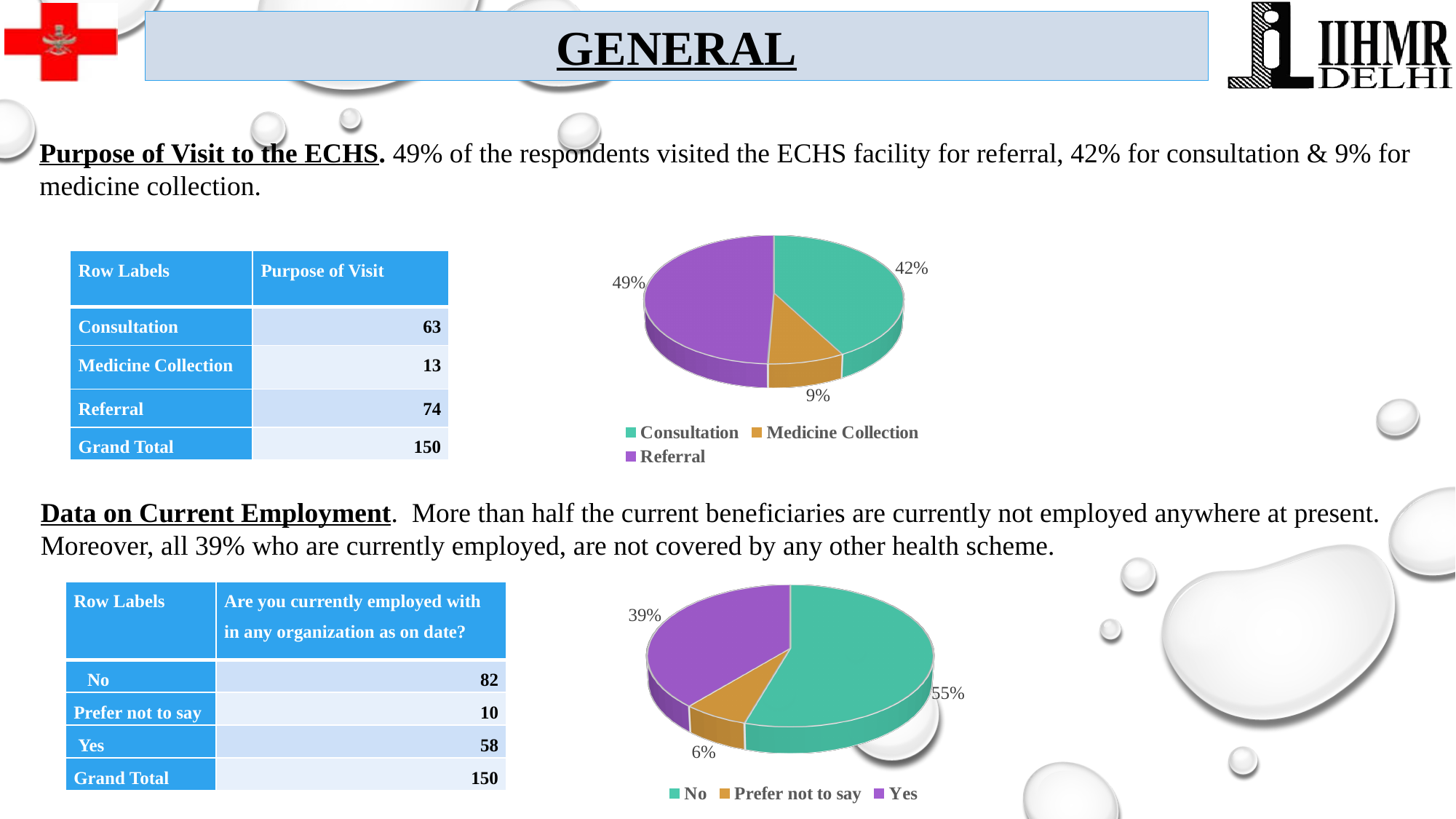
In the bottom pie chart (current employment), which category has the smallest slice? Prefer not to say What kind of chart is the bottom chart on the slide (current employment)? Pie chart In the top pie chart (Purpose of Visit), what is the difference between the Referral and Consultation percentages? 7% In the bottom pie chart (current employment), what percentage is shown for No? 55% In the top pie chart (Purpose of Visit), which category has the largest slice? Referral In the top pie chart (Purpose of Visit), which category has the smallest slice? Medicine Collection In the top pie chart (Purpose of Visit), what percentage is shown for Consultation? 42% How many slices does the top pie chart (Purpose of Visit) have? 3 In the bottom pie chart (current employment), what share of the pie does Yes take? 39% In the top pie chart (Purpose of Visit), what share of the pie does Referral take? 49% How many entries does the legend of the bottom pie chart (current employment) list? 3 In the bottom pie chart (current employment), which is larger: No or Yes? No